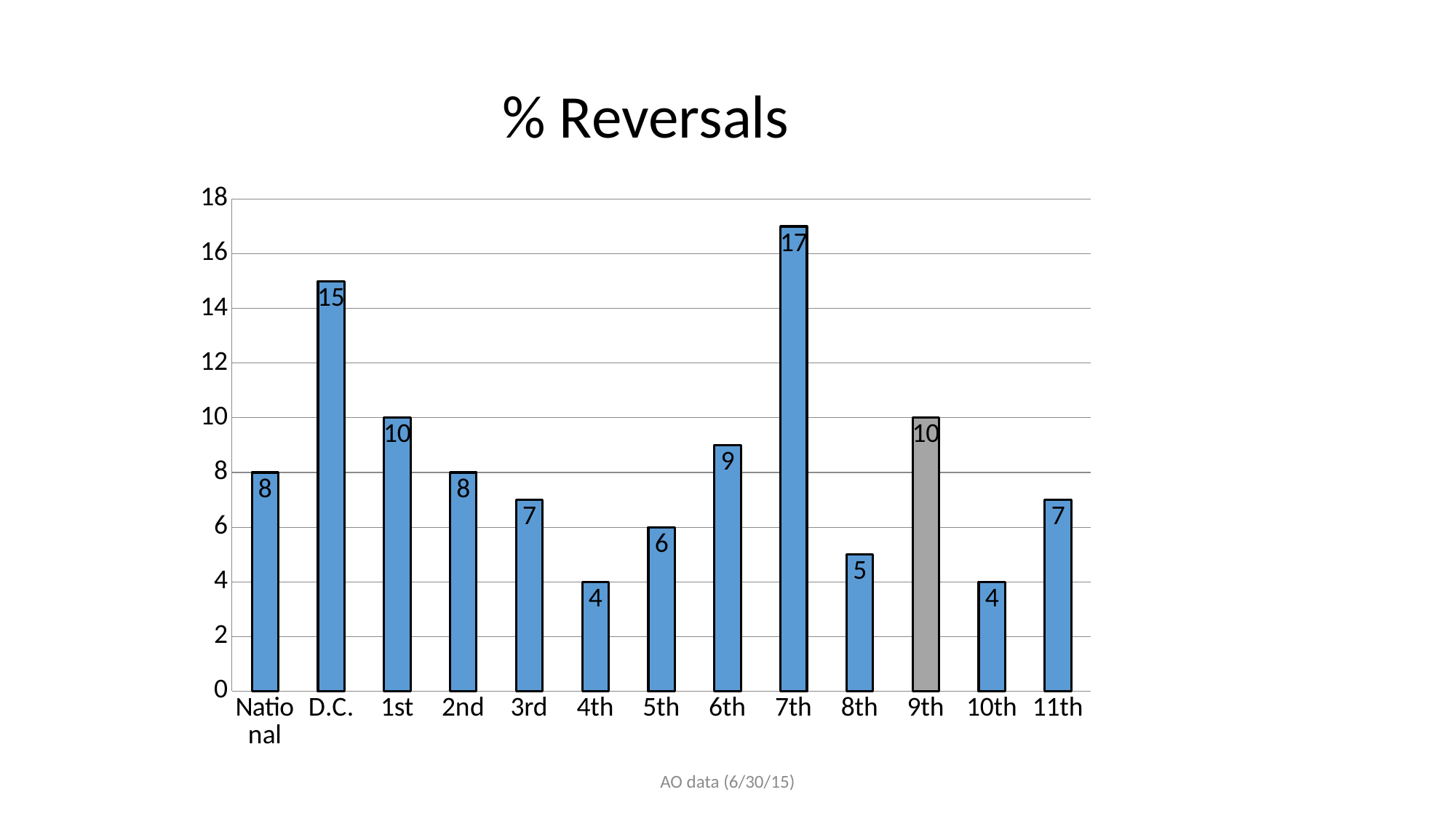
What is the title of the chart? % Reversals What is the value for D.C.? 15 Which categories share the lowest value? 4th and 10th What kind of chart is this? bar chart Which bar is coloured grey instead of blue? 9th Which is larger, the value for 6th or the value for 8th? 6th What is the National value? 8 Which category has the highest value? 7th How many categories are shown on the x axis? 13 Is the value for D.C. greater or less than 14? greater What is the difference between the 7th and D.C. values? 2 What is the value for the 7th circuit? 17